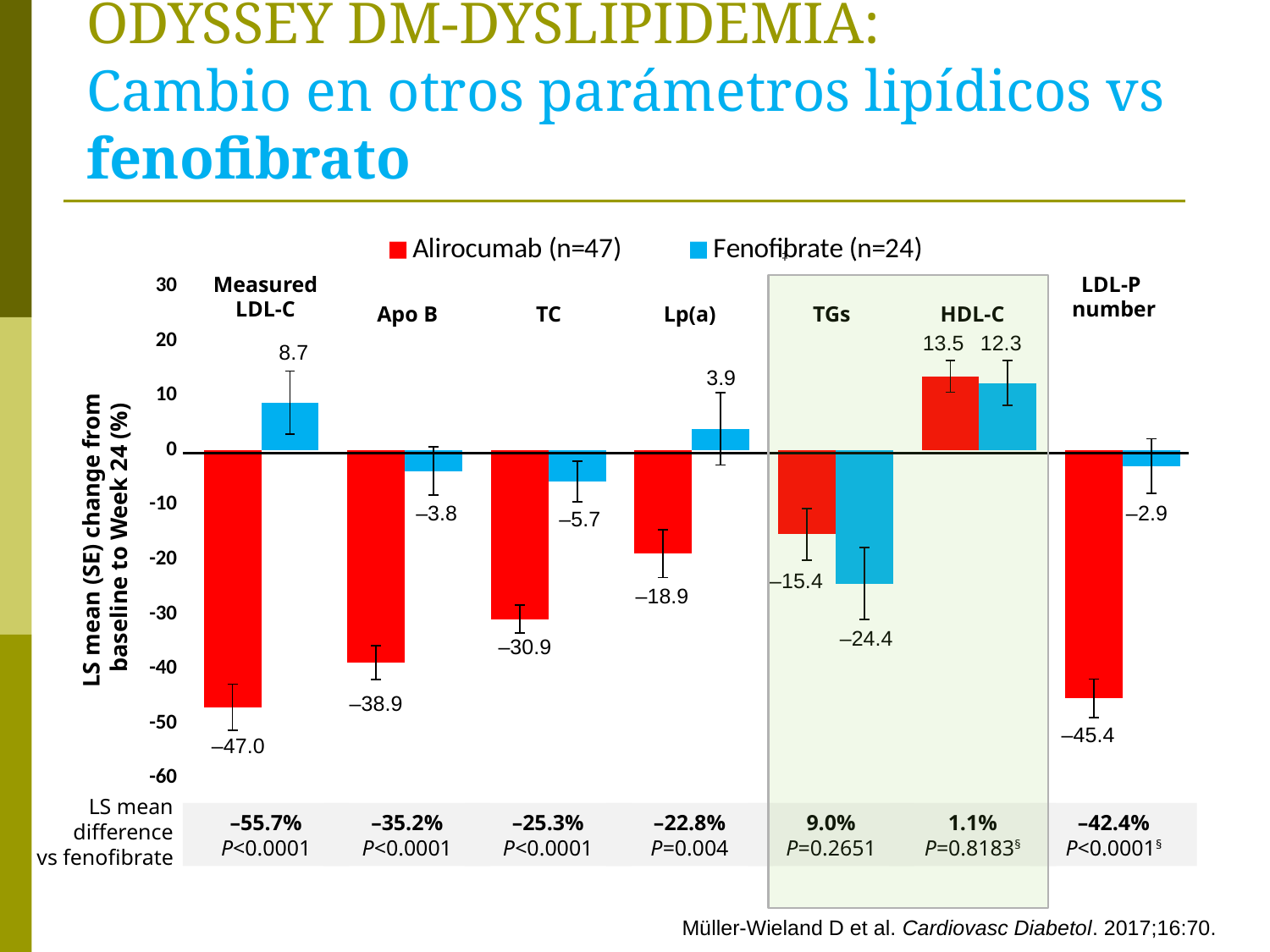
What kind of chart is shown on the slide? Bar chart What is the LS mean difference vs fenofibrate shown for LDL-P number? –42.4% What is the LS mean change for Alirocumab in HDL-C? 13.5 How many series does the legend list? 2 Which series has the larger decrease in TGs, Alirocumab or Fenofibrate? Fenofibrate For which parameter does Alirocumab show the lowest (most negative) LS mean change? Measured LDL-C What is the LS mean change for Alirocumab in Measured LDL-C? –47.0 For which parameter does Fenofibrate show the highest LS mean change? HDL-C What is the LS mean change for Fenofibrate in TGs? –24.4 What is the difference between the Alirocumab and Fenofibrate values for HDL-C? 1.2 How many lipid parameters are shown on the x axis of the chart? 7 What is the LS mean change for Fenofibrate in Measured LDL-C? 8.7